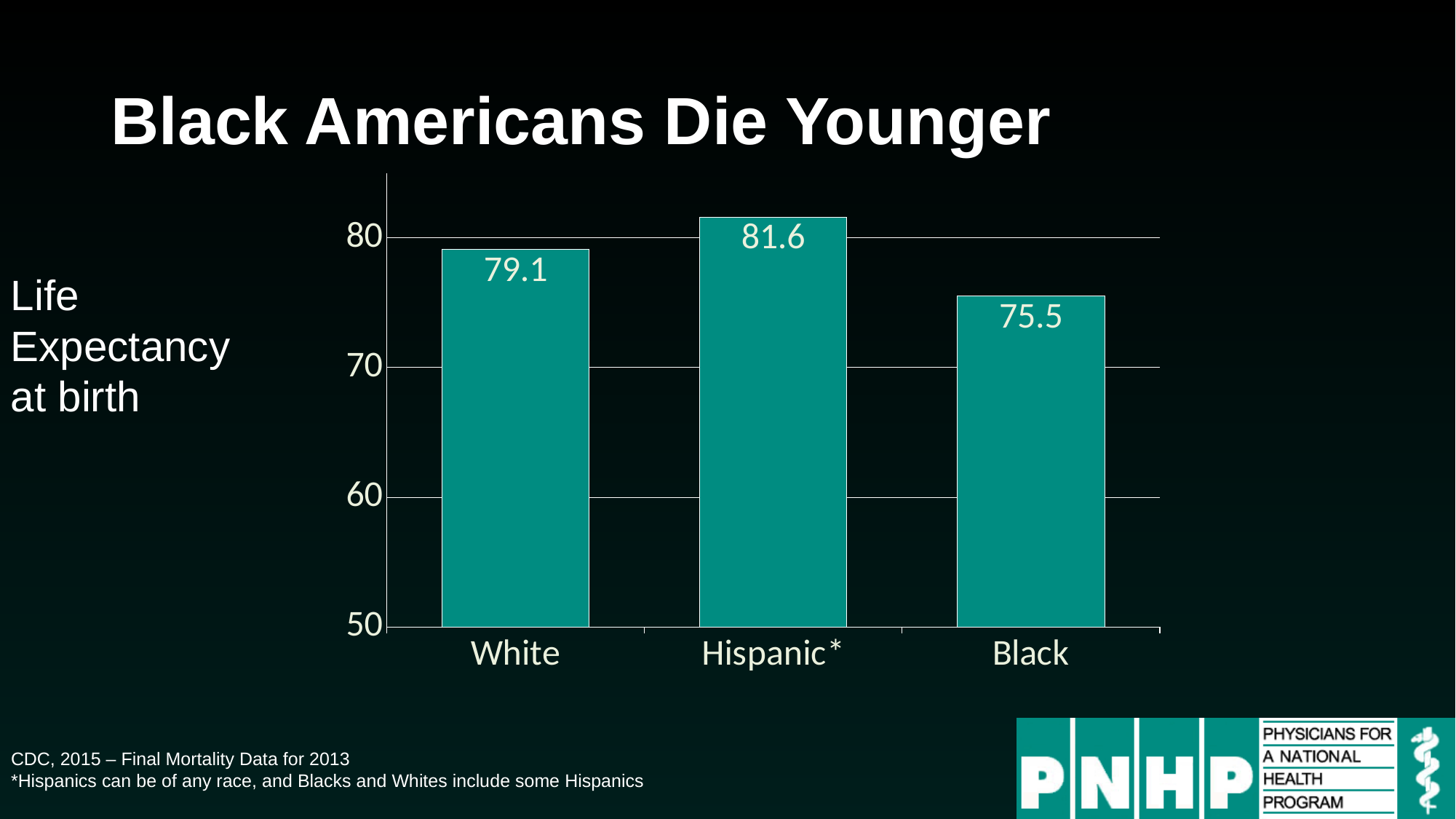
What is the life expectancy at birth for Hispanic Americans shown on the chart? 81.6 What is the difference in life expectancy between the Hispanic and Black bars? 6.1 What is the difference in life expectancy between the White and Black bars? 3.6 Which group has the highest life expectancy at birth on the chart? Hispanic Which is larger, the life expectancy for White or for Black Americans? White What is the life expectancy at birth for White Americans shown on the chart? 79.1 How many groups are shown on the chart? 3 What kind of chart is shown on the slide? bar chart What is the title of the slide containing the chart? Black Americans Die Younger What is the life expectancy at birth for Black Americans shown on the chart? 75.5 Is the value for Black greater or less than 80? less Which group has the lowest life expectancy at birth on the chart? Black